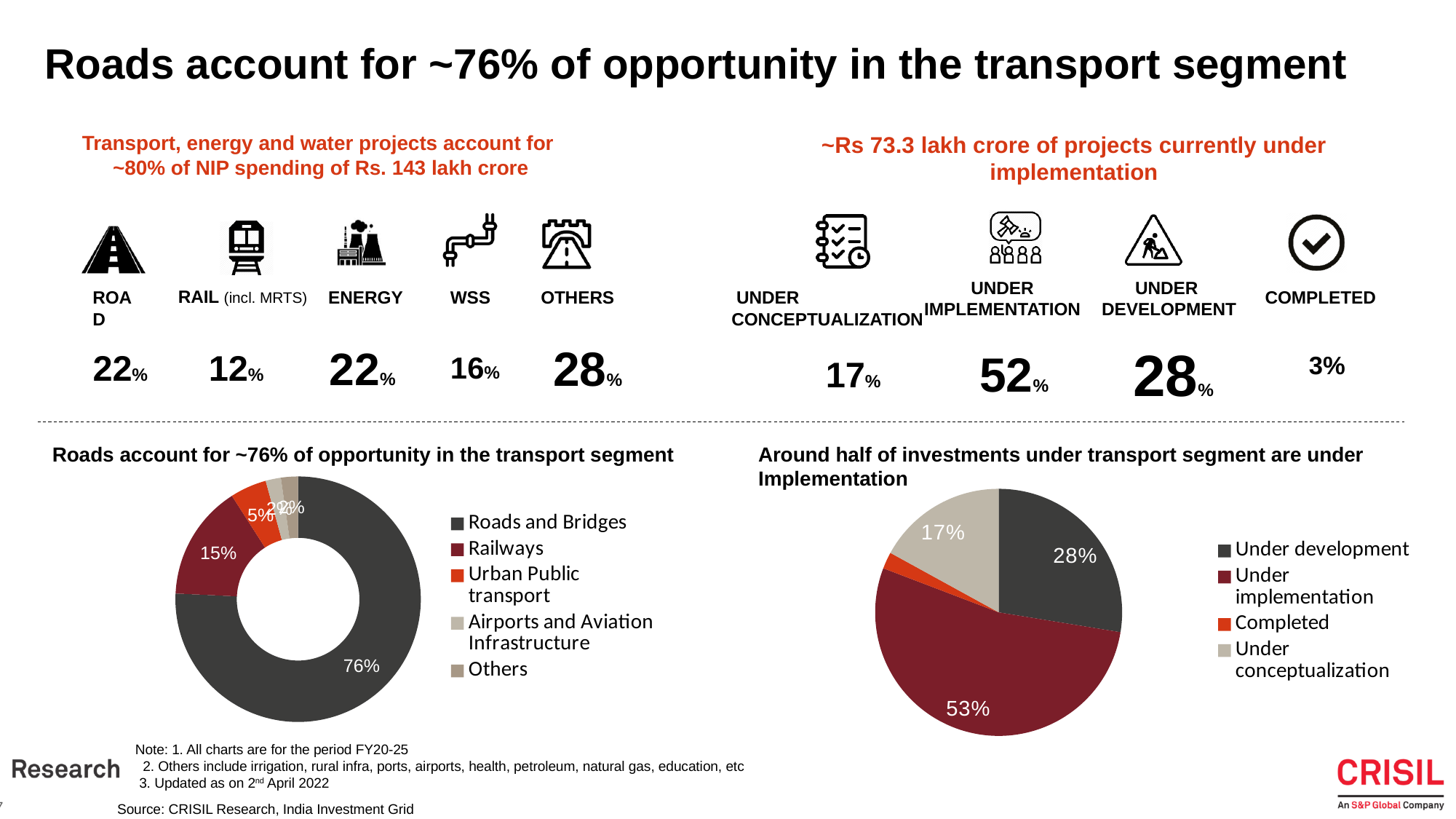
In the right pie chart, what share is labelled for Under development? 28% In the right pie chart, which category has the smallest share? Completed In the right pie chart, what share is labelled for Under conceptualization? 17% In the left donut chart, what share is labelled for Urban Public transport? 5% In the left donut chart, how many categories does the legend list? 5 In the right pie chart, which is larger: Under development or Under conceptualization? Under development In the right pie chart titled 'Around half of investments under transport segment are under Implementation', what share is labelled for Under implementation? 53% In the left donut chart, what is the difference between the Roads and Bridges share and the Railways share? 61% What kind of chart is the right chart titled 'Around half of investments under transport segment are under Implementation'? Pie chart In the left donut chart titled 'Roads account for ~76% of opportunity in the transport segment', what share is labelled for Roads and Bridges? 76% In the left donut chart, what share is labelled for Railways? 15% In the left donut chart, which category has the largest share? Roads and Bridges